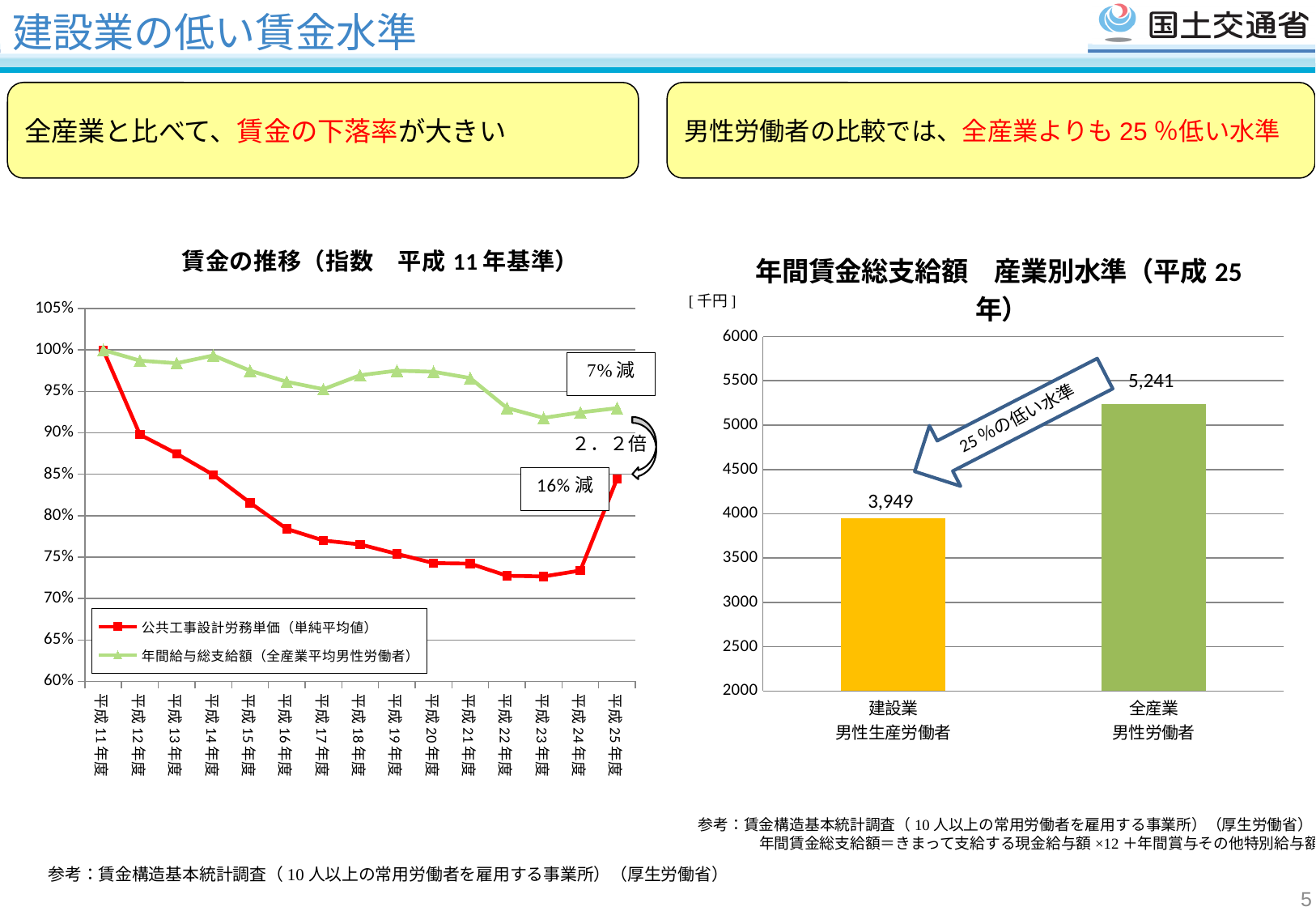
In the chart titled 賃金の推移（指数 平成11年基準）, is the value of 公共工事設計労務単価（単純平均値） for 平成22年度 greater or less than 75%? less In the chart titled 年間賃金総支給額 産業別水準（平成25年）, which category has the higher value? 全産業 男性労働者 What kind of chart is the one titled 賃金の推移（指数 平成11年基準）? line chart In the chart titled 年間賃金総支給額 産業別水準（平成25年）, what is the difference between the value for 全産業 男性労働者 and the value for 建設業 男性生産労働者? 1,292 In the chart titled 年間賃金総支給額 産業別水準（平成25年）, what is the value for 全産業 男性労働者? 5,241 In the chart titled 年間賃金総支給額 産業別水準（平成25年）, what is the value for 建設業 男性生産労働者? 3,949 In the chart titled 賃金の推移（指数 平成11年基準）, does the 公共工事設計労務単価（単純平均値） series rise or fall from 平成11年度 to 平成23年度? fall In the chart titled 賃金の推移（指数 平成11年基準）, is the value of 年間給与総支給額（全産業平均男性労働者） for 平成23年度 greater or less than 95%? less What kind of chart is the one titled 年間賃金総支給額 産業別水準（平成25年）? bar chart In the chart titled 年間賃金総支給額 産業別水準（平成25年）, how many bars are plotted? 2 In the chart titled 賃金の推移（指数 平成11年基準）, how many fiscal years are shown on the x axis? 15 In the chart titled 賃金の推移（指数 平成11年基準）, how many series does the legend list? 2